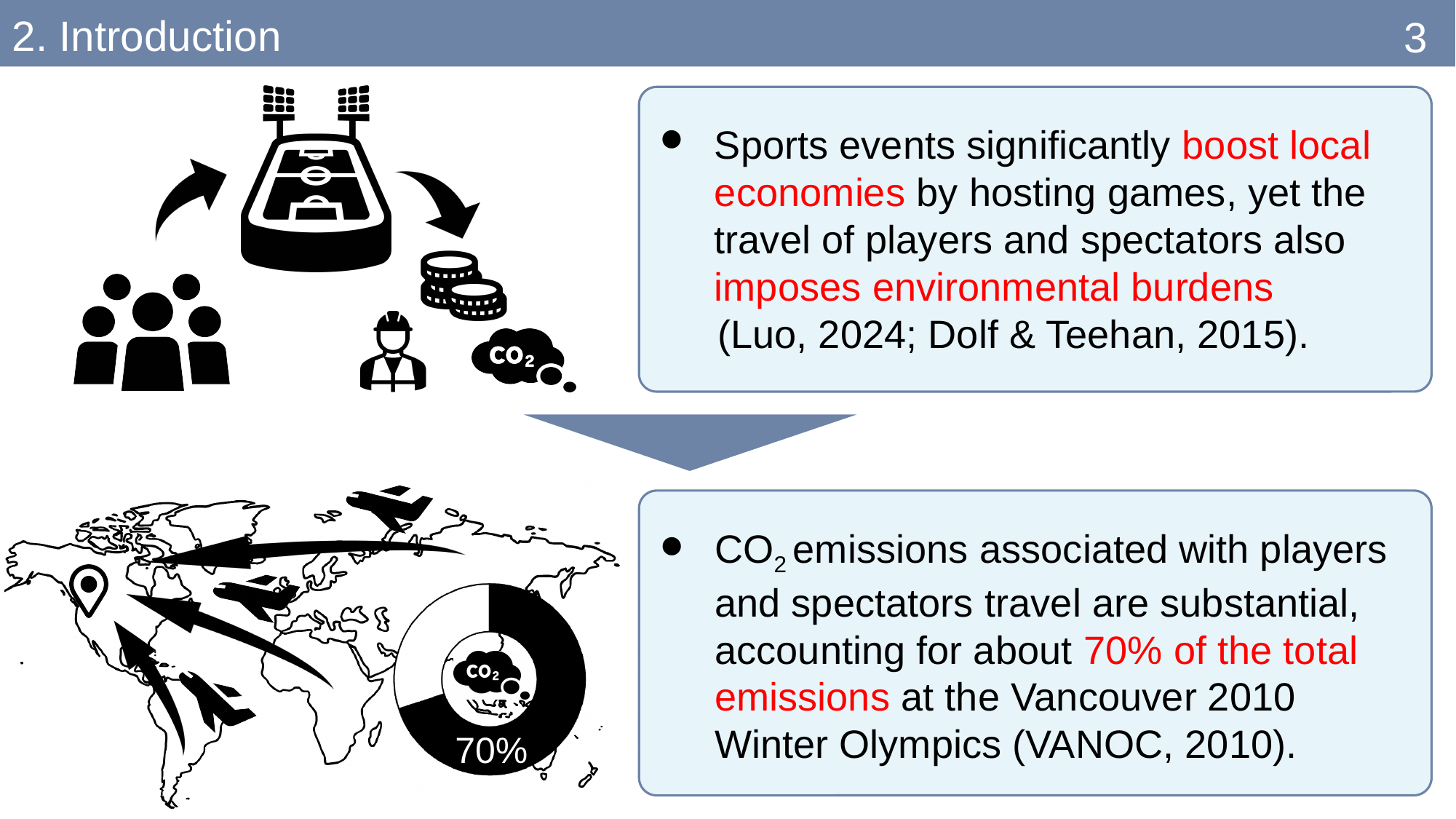
How many segments does the pie chart at the bottom left have? 2 What icon appears in the centre of the pie chart at the bottom left? CO2 cloud What kind of chart is shown over the world map at the bottom left of the slide? pie chart Is the labeled segment of the pie chart at the bottom left more or less than half of the whole? more What share is labeled on the black segment of the pie chart at the bottom left? 70%